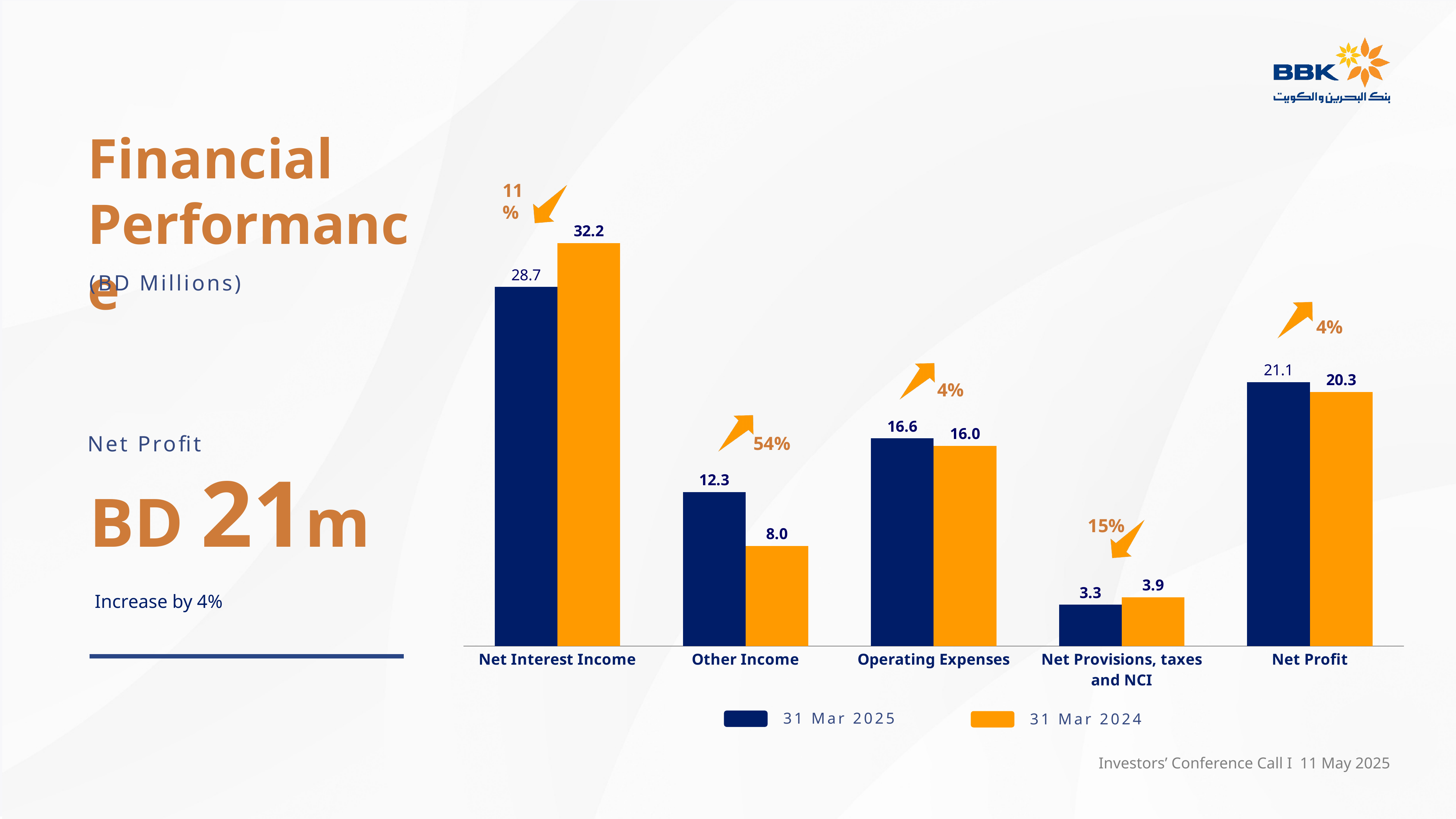
What percentage change is annotated above the Other Income bars? 54% What is the value for Net Provisions, taxes and NCI for 31 Mar 2024? 3.9 How many categories are shown on the x axis of the chart? 5 What kind of chart is shown on the slide? Bar chart What is the value for Net Interest Income for 31 Mar 2025? 28.7 What is the value for Net Profit for 31 Mar 2025? 21.1 Which category has the lowest value for 31 Mar 2025? Net Provisions, taxes and NCI What is the value for Other Income for 31 Mar 2024? 8.0 What is the difference between the 31 Mar 2025 and 31 Mar 2024 values for Other Income? 4.3 Which category has the highest value for 31 Mar 2024? Net Interest Income Which is larger for Net Interest Income: the 31 Mar 2025 value or the 31 Mar 2024 value? 31 Mar 2024 How many series does the legend list? 2